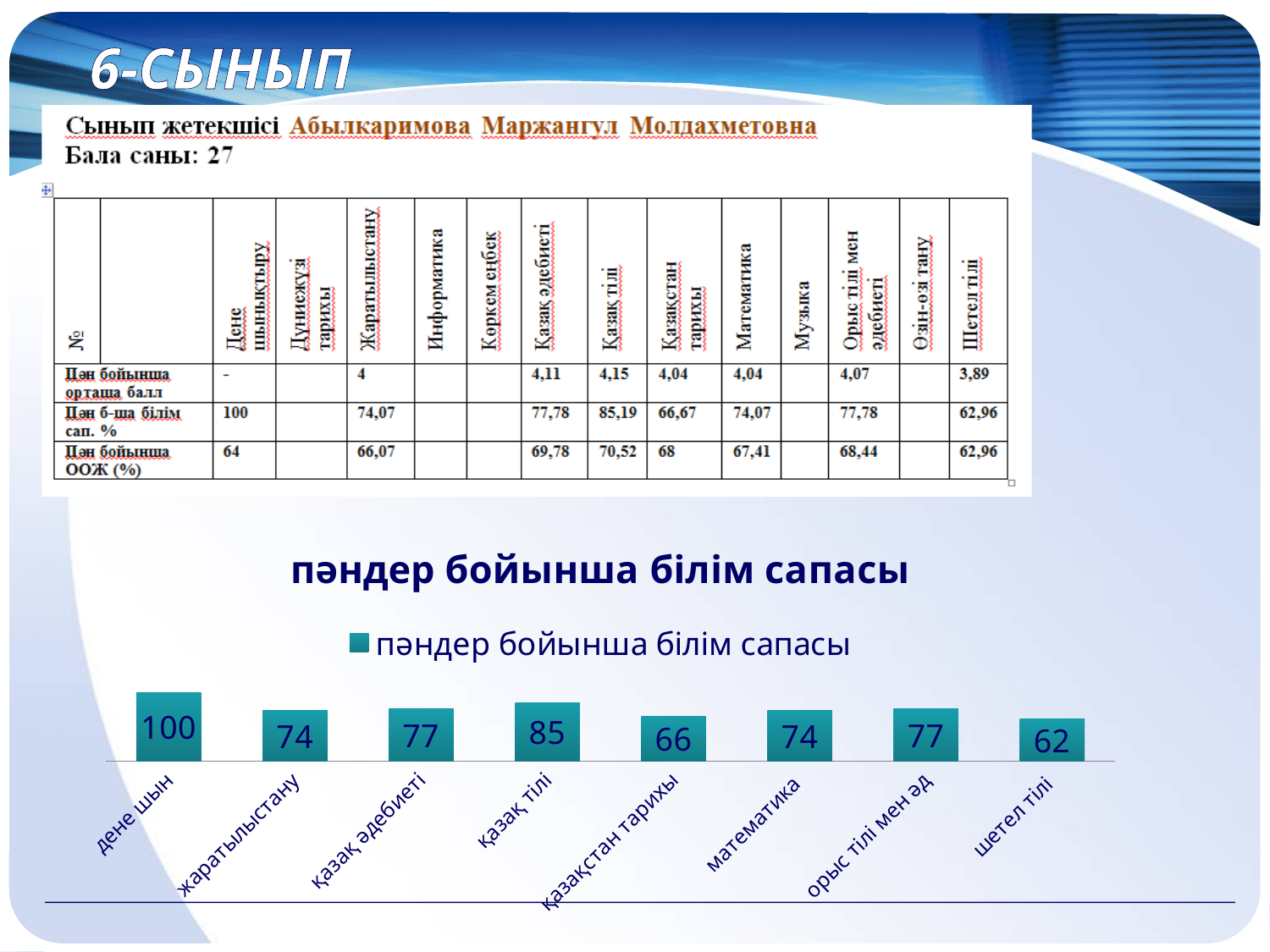
Which category has the lowest value in the chart? шетел тілі What is the value for "дене шын" in the chart? 100 What is the difference between the values for "қазақ тілі" and "математика"? 11 How many series does the chart legend list? 1 What type of chart is shown under the title "пәндер бойынша білім сапасы"? bar chart What is the value for "қазақстан тарихы" in the chart? 66 What is the value for "қазақ тілі" in the chart? 85 How many categories are shown in the chart? 8 What is the value for "шетел тілі" in the chart? 62 What is the difference between the values for "дене шын" and "шетел тілі"? 38 Which category has the highest value in the chart? дене шын Which is larger, the value for "қазақ әдебиеті" or the value for "қазақстан тарихы"? қазақ әдебиеті